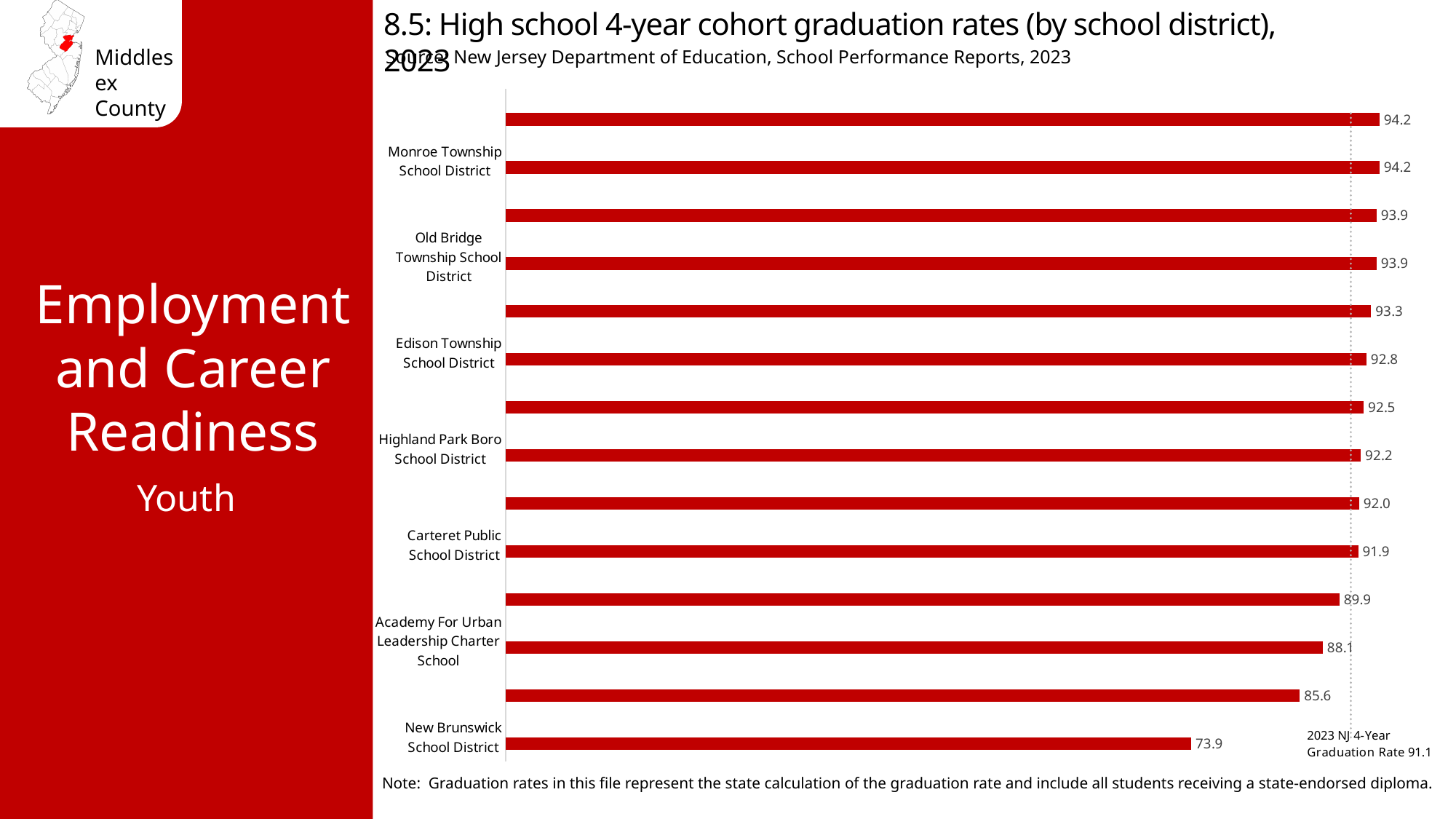
What is the difference between the graduation rates of Monroe Township School District and New Brunswick School District? 20.3 What kind of chart is shown on the slide? Bar chart What is the difference between the graduation rates of Old Bridge Township School District and Academy For Urban Leadership Charter School? 5.8 How many bars are plotted on the chart? 14 What is the graduation rate for Academy For Urban Leadership Charter School? 88.1 What is the graduation rate shown for New Brunswick School District? 73.9 What value does the dotted reference line on the chart represent? 2023 NJ 4-Year Graduation Rate 91.1 Which has a higher graduation rate, Carteret Public School District or Academy For Urban Leadership Charter School? Carteret Public School District What is the 4-year cohort graduation rate for Monroe Township School District? 94.2 Which labeled school district has the lowest graduation rate on the chart? New Brunswick School District What is the graduation rate for Edison Township School District? 92.8 What is the highest graduation rate value shown on the chart? 94.2